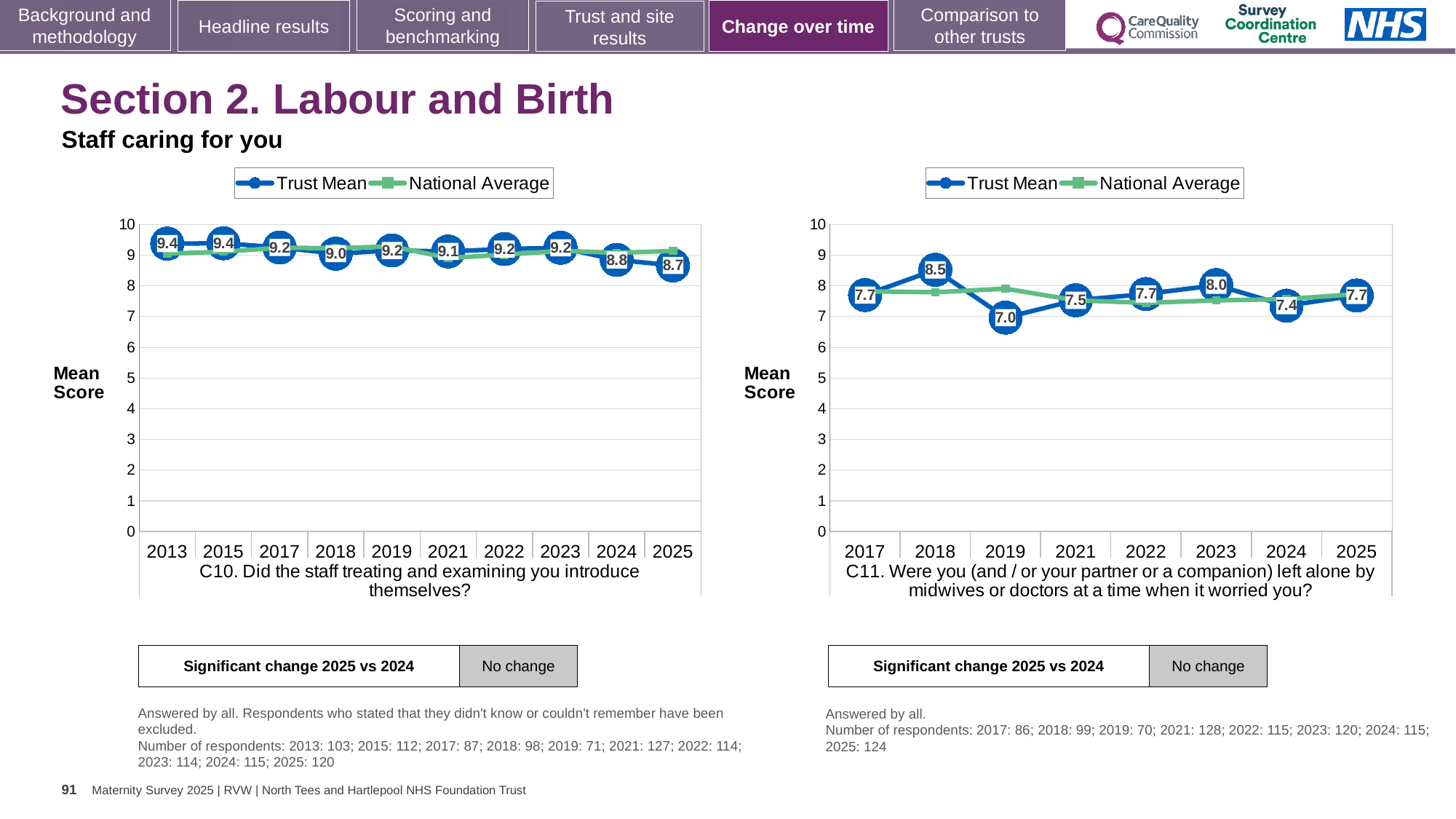
In the C10 chart, which year has the lowest Trust Mean score? 2025 In the C10 chart, what is the difference between the Trust Mean scores for 2013 and 2025? 0.7 In the C11 chart, what is the difference between the Trust Mean scores for 2018 and 2019? 1.5 In the C11 chart, what is the Trust Mean score for 2019? 7.0 In the C10 chart, what is the Trust Mean score for 2025? 8.7 How many series does the legend of the C11 chart list? 2 What kind of chart is the C10 chart? Line chart In the C11 chart, is the Trust Mean score for 2023 greater or less than the Trust Mean score for 2024? greater In the C10 chart, how many years are shown on the x axis? 10 In the C10 chart, what is the Trust Mean score for 2018? 9.0 In the C11 chart, which year has the lowest Trust Mean score? 2019 In the C11 chart, which year has the highest Trust Mean score? 2018